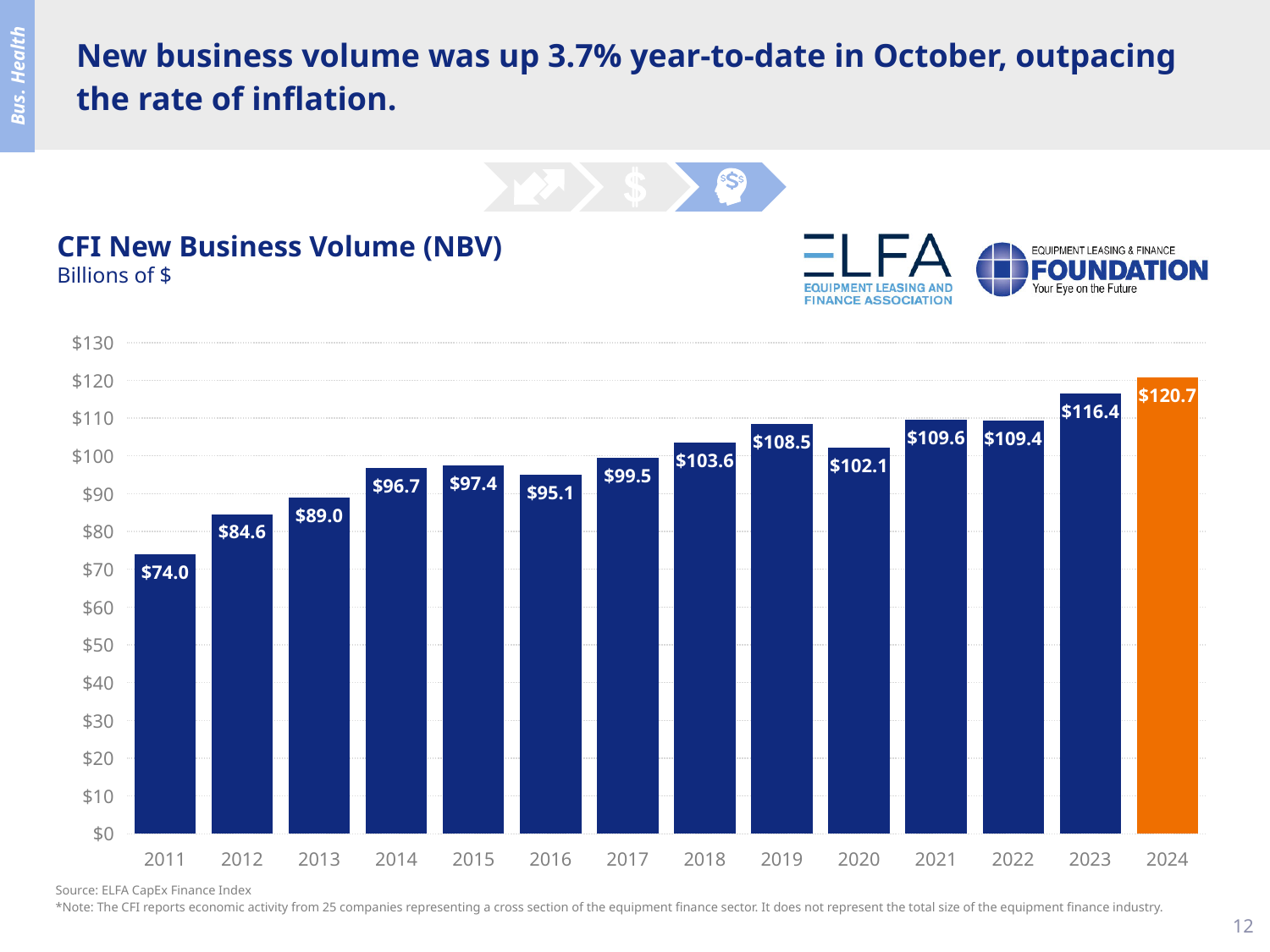
What is the CFI New Business Volume for 2011? $74.0 Which year has the lowest CFI New Business Volume? 2011 What unit is the CFI New Business Volume chart measured in, according to its subtitle? Billions of $ How many years are shown on the CFI New Business Volume chart? 14 What is the CFI New Business Volume for 2024? $120.7 What is the difference between the CFI New Business Volume in 2019 and in 2020? $6.4 Is the CFI New Business Volume for 2013 greater or less than $90? less What kind of chart is used to show CFI New Business Volume? Bar chart Which year has the highest CFI New Business Volume? 2024 What is the CFI New Business Volume for 2020? $102.1 Which year has a larger CFI New Business Volume, 2015 or 2016? 2015 What is the difference between the CFI New Business Volume in 2024 and in 2023? $4.3